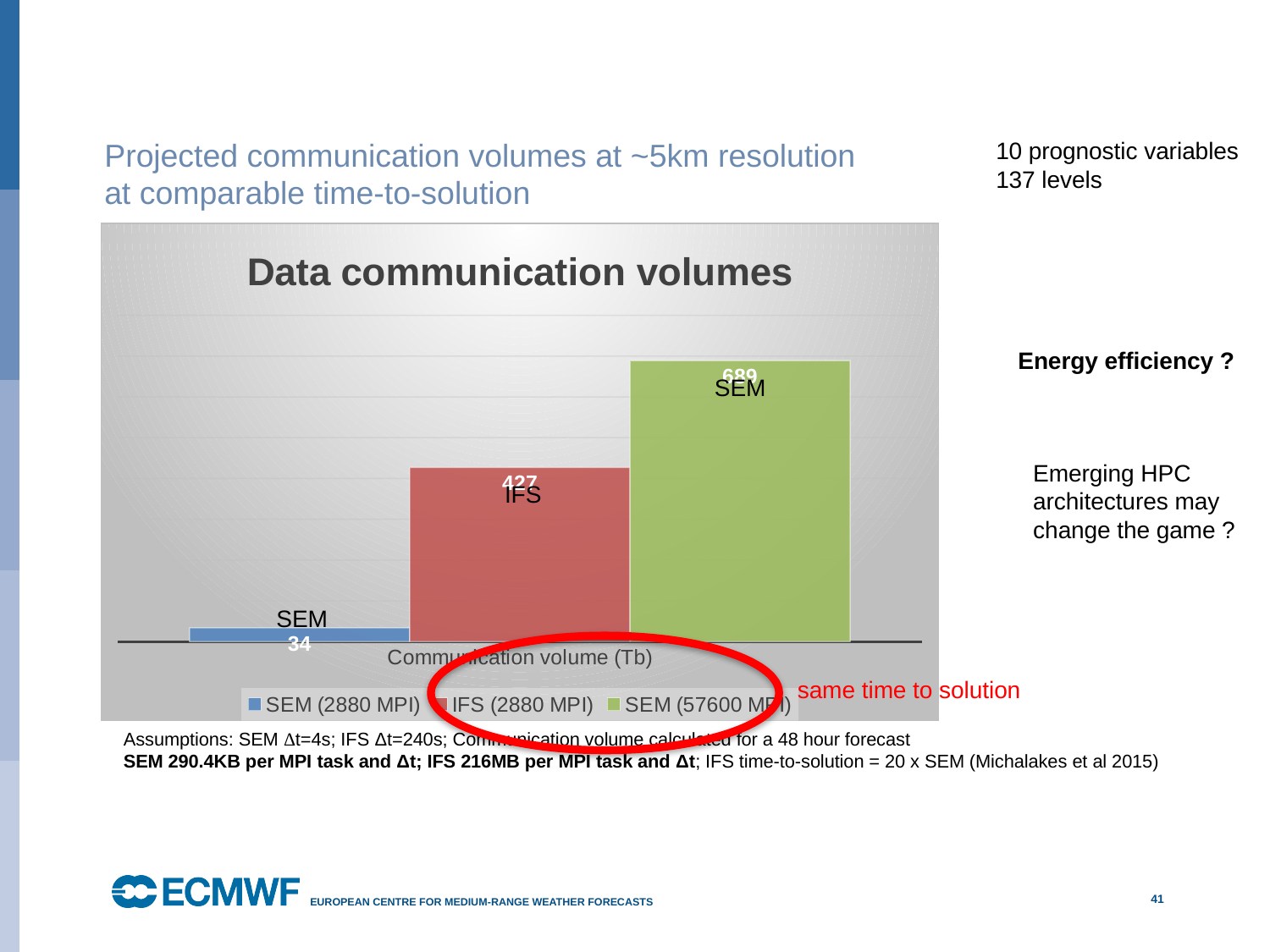
Which series has the lowest communication volume? SEM (2880 MPI) What is the label on the x axis category? Communication volume (Tb) What is the data communication volume for IFS (2880 MPI)? 427 Which series has the highest communication volume? SEM (57600 MPI) What is the difference in communication volume between SEM (57600 MPI) and IFS (2880 MPI)? 262 What kind of chart is shown? Bar chart What is the difference in communication volume between IFS (2880 MPI) and SEM (2880 MPI)? 393 How many series does the legend list? 3 What is the data communication volume for SEM (57600 MPI)? 689 Which has a larger communication volume, IFS (2880 MPI) or SEM (2880 MPI)? IFS (2880 MPI) What is the data communication volume for SEM (2880 MPI)? 34 What is the title of the chart? Data communication volumes